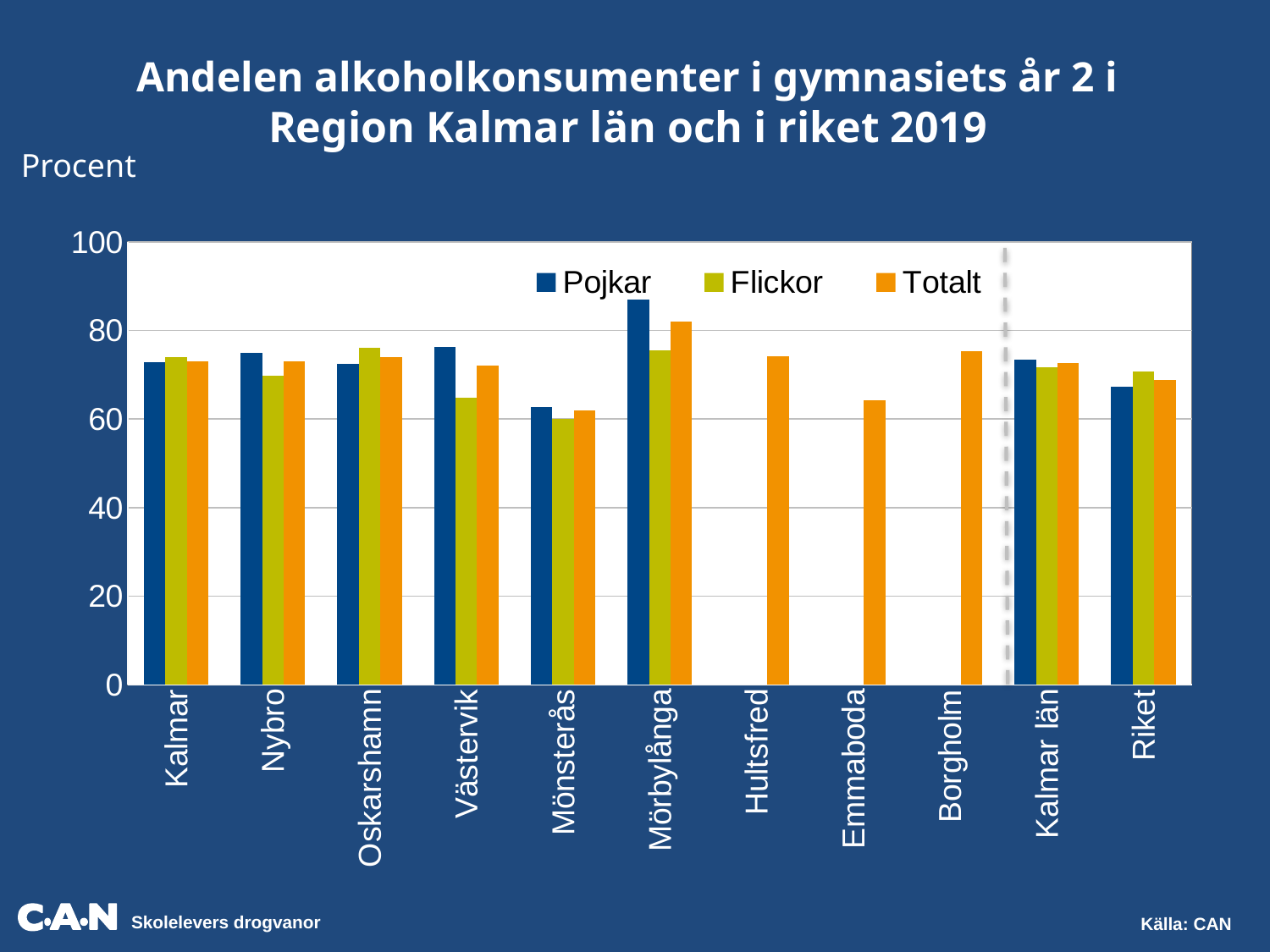
For Västervik, which is larger: the Pojkar value or the Flickor value? Pojkar How many series does the legend list? 3 How many categories are shown on the x axis? 11 For Oskarshamn, which is larger: the Pojkar value or the Flickor value? Flickor Which category has the highest Totalt value? Mörbylånga Which series is shown in orange in the legend? Totalt Which category has the lowest Flickor value? Mönsterås What kind of chart is shown on the slide? bar chart Is the Totalt value for Emmaboda greater or less than 60? greater Is the Pojkar value for Mörbylånga greater or less than 80? greater Is the Totalt value for Hultsfred greater or less than 80? less Which category has the highest Pojkar value? Mörbylånga